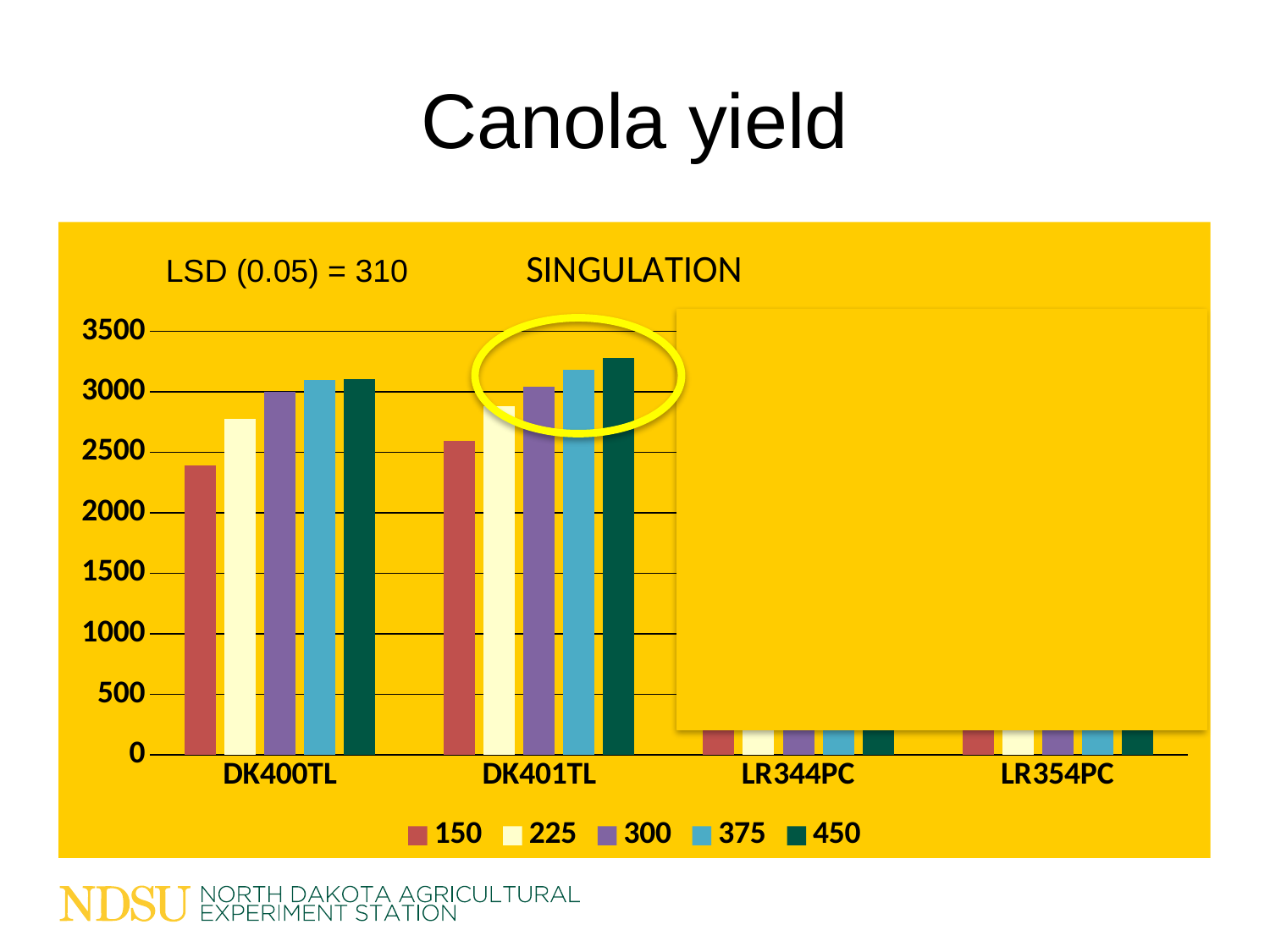
How many series does the legend list? 5 Which series has the highest value for DK401TL? 450 What LSD (0.05) value is printed on the chart? 310 What kind of chart is shown on the slide? bar chart Is the value for the 450 series at DK401TL greater or less than 3000? greater Which is larger for the 150 series: DK400TL or DK401TL? DK401TL How many categories are shown on the x axis? 4 Is the value for the 150 series at DK400TL greater or less than 2500? less Is the value for the 225 series at DK400TL greater or less than 2500? greater Which series has the lowest value for DK400TL? 150 What is the title of the slide containing the chart? Canola yield